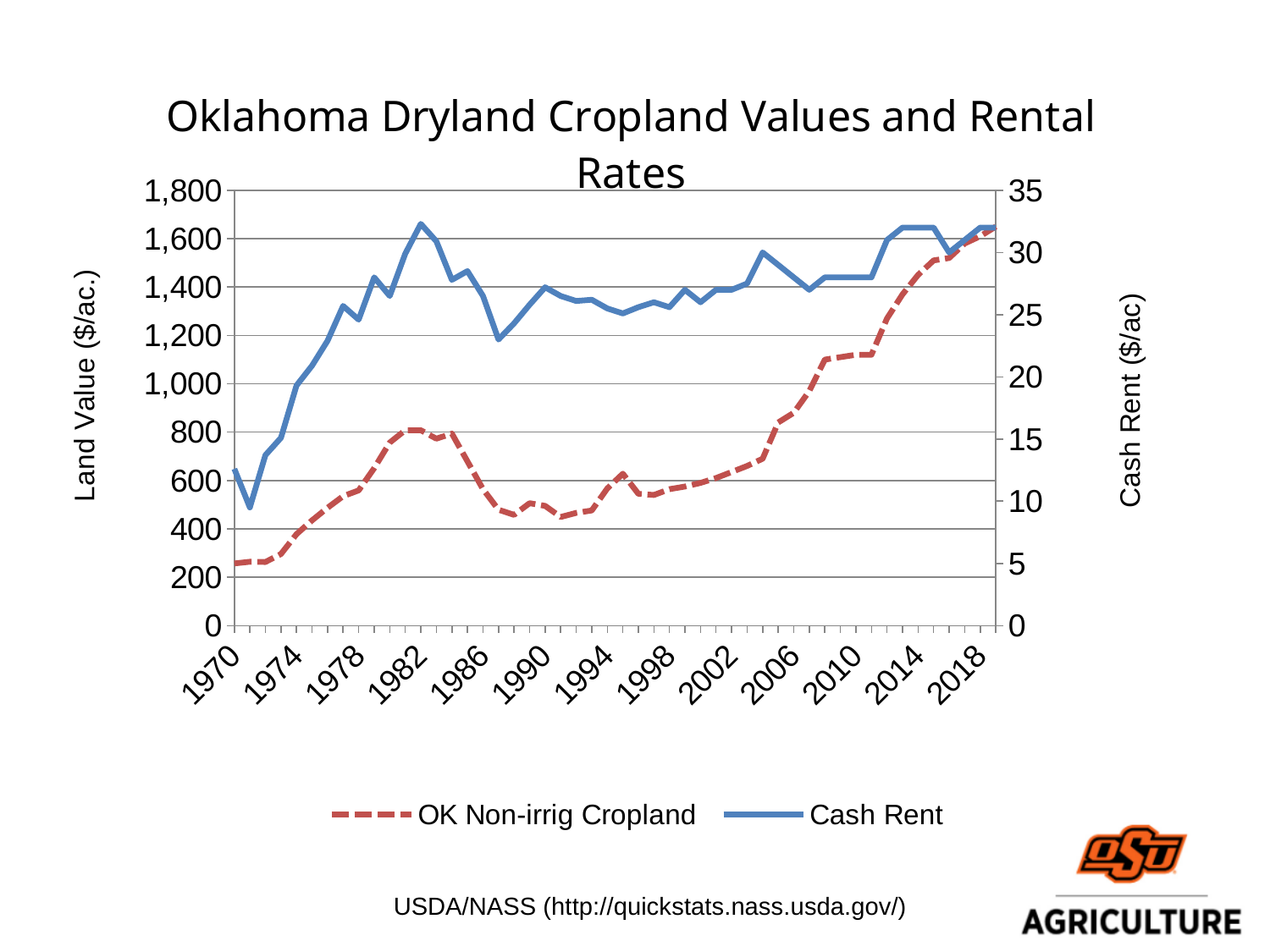
Is the OK Non-irrig Cropland value in 1982 greater or less than 600? greater What kind of chart is shown on the slide? line chart Does the Cash Rent value rise or fall between 1970 and 1982? rise Does the OK Non-irrig Cropland value rise or fall between 2002 and 2018? rise Is the Cash Rent value in 1982 greater or less than 30? greater What is the title of the chart? Oklahoma Dryland Cropland Values and Rental Rates What is the label of the right-hand vertical axis? Cash Rent ($/ac) Is the Cash Rent value in 1970 greater or less than 20? less How many series does the legend list? 2 Which year has the larger OK Non-irrig Cropland value, 1970 or 2018? 2018